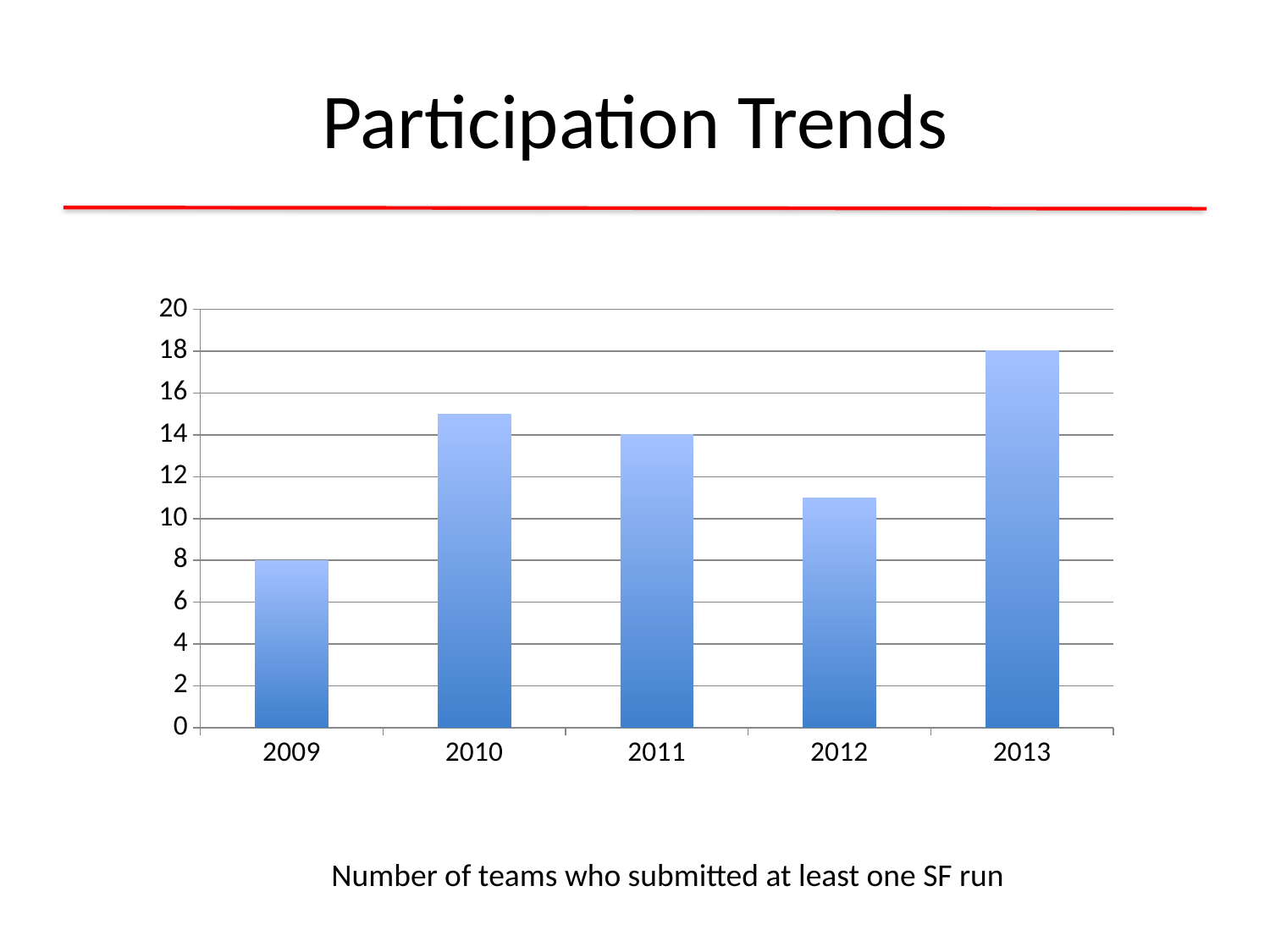
What is the value for 2011? 14 What is the title of the slide? Participation Trends What is the value for 2013? 18 Which year has the highest value? 2013 What kind of chart is shown on the slide? bar chart What is the value for 2009? 8 Is the value for 2012 greater or less than 14? less How many years are shown on the x axis? 5 Is the value for 2010 greater or less than 10? greater What is the difference between the values for 2013 and 2009? 10 Which is larger, the value for 2011 or the value for 2012? 2011 Which year has the lowest value? 2009